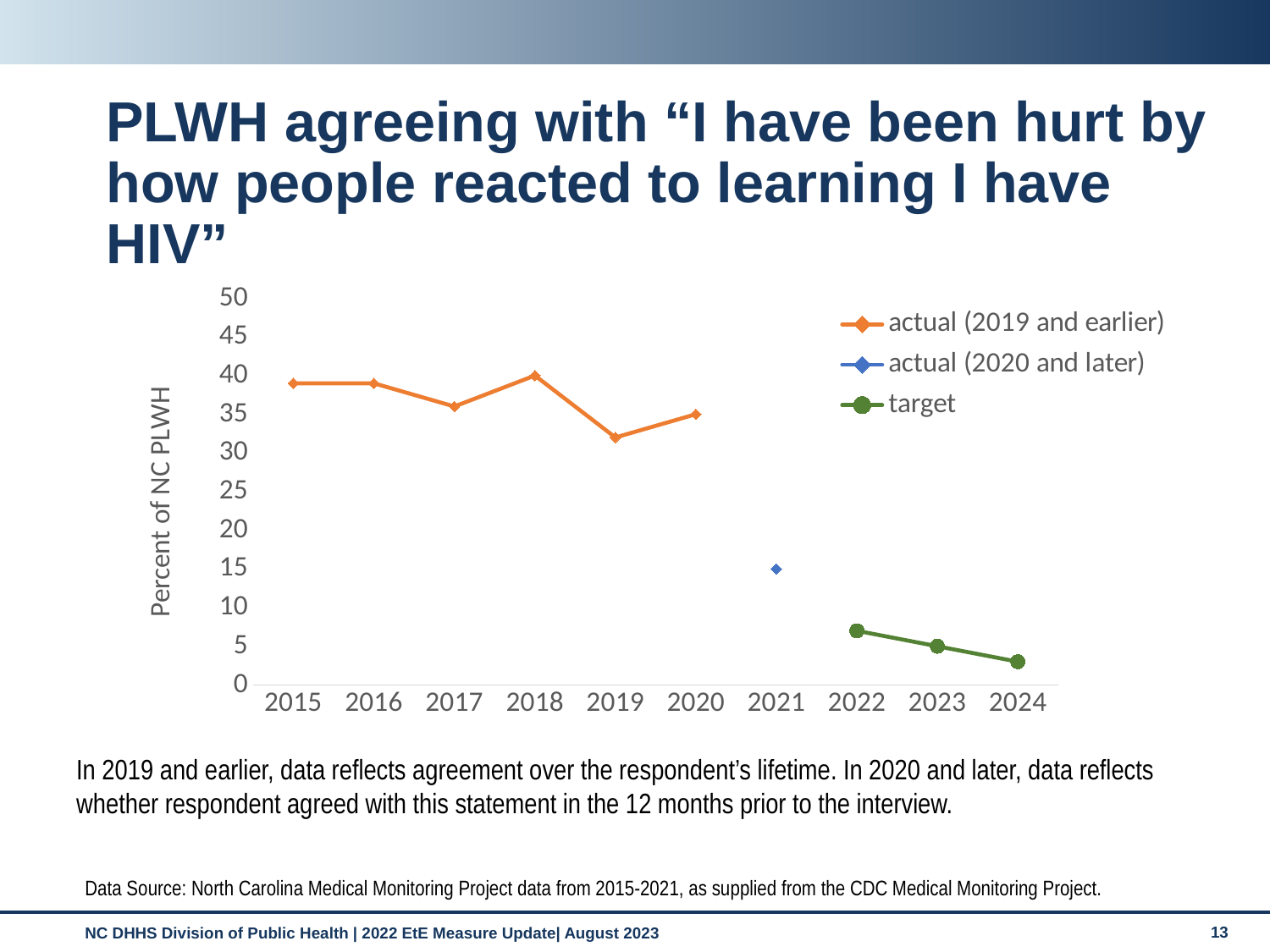
What is the label on the y axis? Percent of NC PLWH Is the value for actual (2020 and later) in 2021 greater or less than 20? less Which is larger, the actual value for 2017 or the actual value for 2019? 2017 What kind of chart is shown on the slide? line chart Which year has the lowest value in the actual (2019 and earlier) series? 2019 How many years are shown on the x axis? 10 How many series does the legend list? 3 Is the target value for 2024 greater or less than 5? less Do the target values rise or fall from 2022 to 2024? fall Is the value for actual (2019 and earlier) in 2018 greater or less than 35? greater What colour is the target series line? green